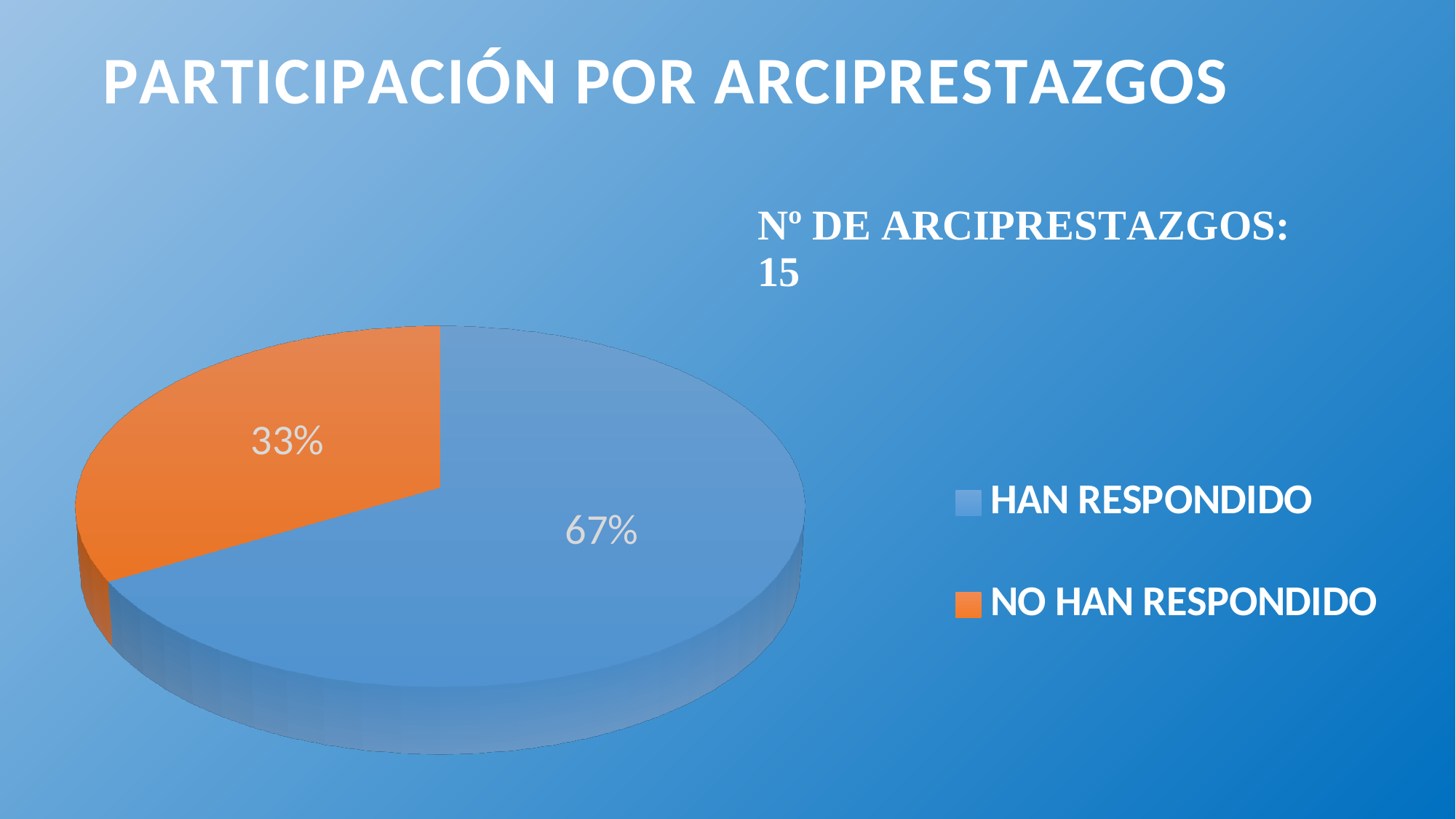
What percentage of the pie chart corresponds to HAN RESPONDIDO? 67% What percentage of the pie chart corresponds to NO HAN RESPONDIDO? 33% Which category has the largest share of the pie chart? HAN RESPONDIDO What is the title of the slide containing the chart? PARTICIPACIÓN POR ARCIPRESTAZGOS How many entries does the legend list? 2 What kind of chart is shown on the slide? Pie chart Which category has the smallest share of the pie chart? NO HAN RESPONDIDO What share of the pie does the orange slice represent? 33% How many slices does the pie chart have? 2 Which is larger, the share for HAN RESPONDIDO or the share for NO HAN RESPONDIDO? HAN RESPONDIDO Which colour represents NO HAN RESPONDIDO in the pie chart? Orange What is the difference in percentage points between HAN RESPONDIDO and NO HAN RESPONDIDO? 34